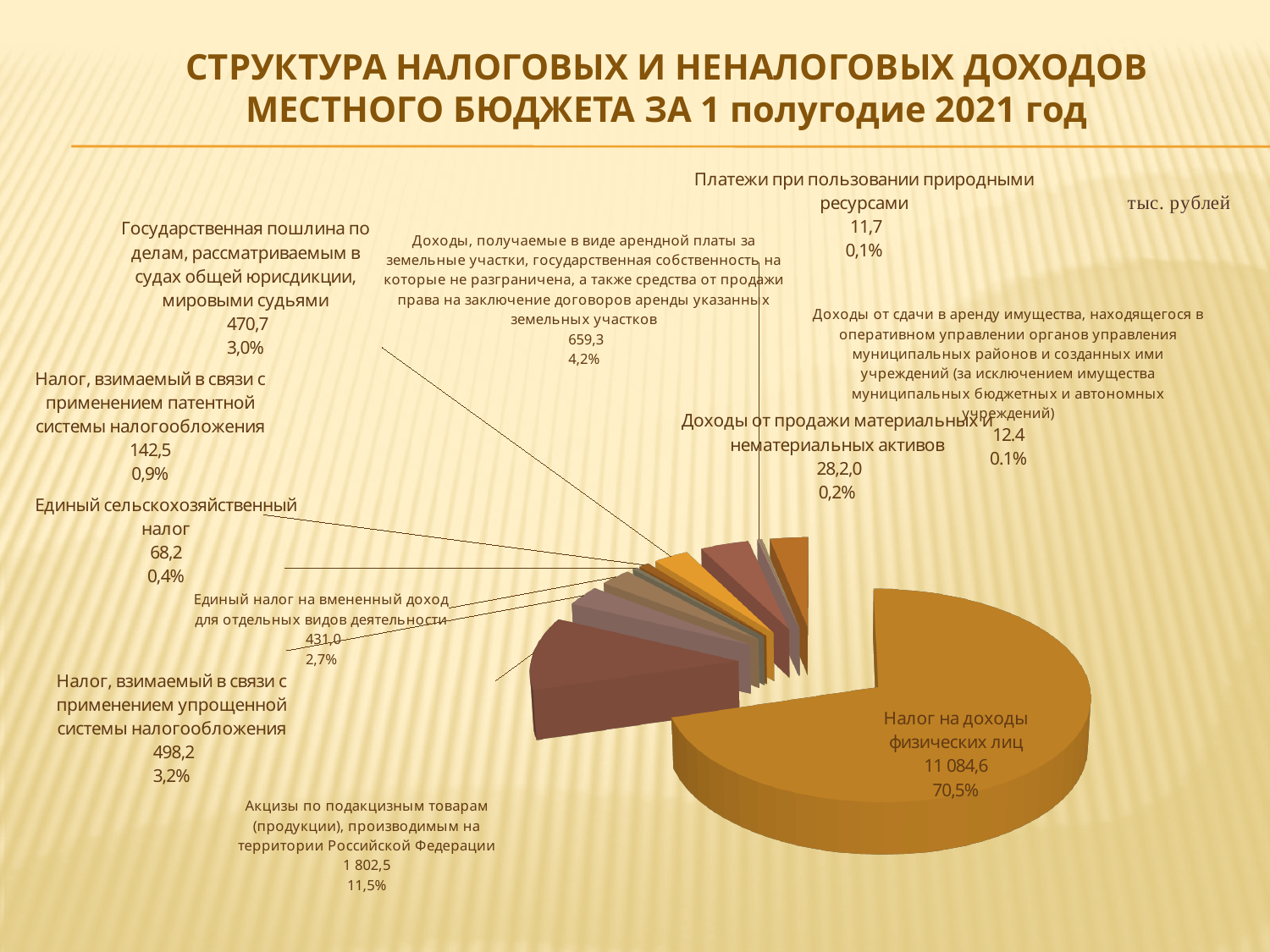
What is the value for Налог на доходы физических лиц? 11 084,6 What is the value for Доходы, получаемые в виде арендной платы за земельные участки, государственная собственность на которые не разграничена? 659,3 What kind of chart is shown on the slide? Pie chart What share of the pie does Единый налог на вмененный доход для отдельных видов деятельности represent? 2,7% What is the value for Акцизы по подакцизным товарам (продукции), производимым на территории Российской Федерации? 1 802,5 In what units are the values on the chart given? тыс. рублей Which is larger: the value for Налог, взимаемый в связи с применением упрощенной системы налогообложения or the value for Государственная пошлина по делам, рассматриваемым в судах общей юрисдикции, мировыми судьями? Налог, взимаемый в связи с применением упрощенной системы налогообложения Which category has the largest slice of the pie? Налог на доходы физических лиц Which category has the smallest value in the chart? Платежи при пользовании природными ресурсами What share of the pie does Налог на доходы физических лиц represent? 70,5% What is the difference between the values for Налог на доходы физических лиц and Акцизы по подакцизным товарам? 9 282,1